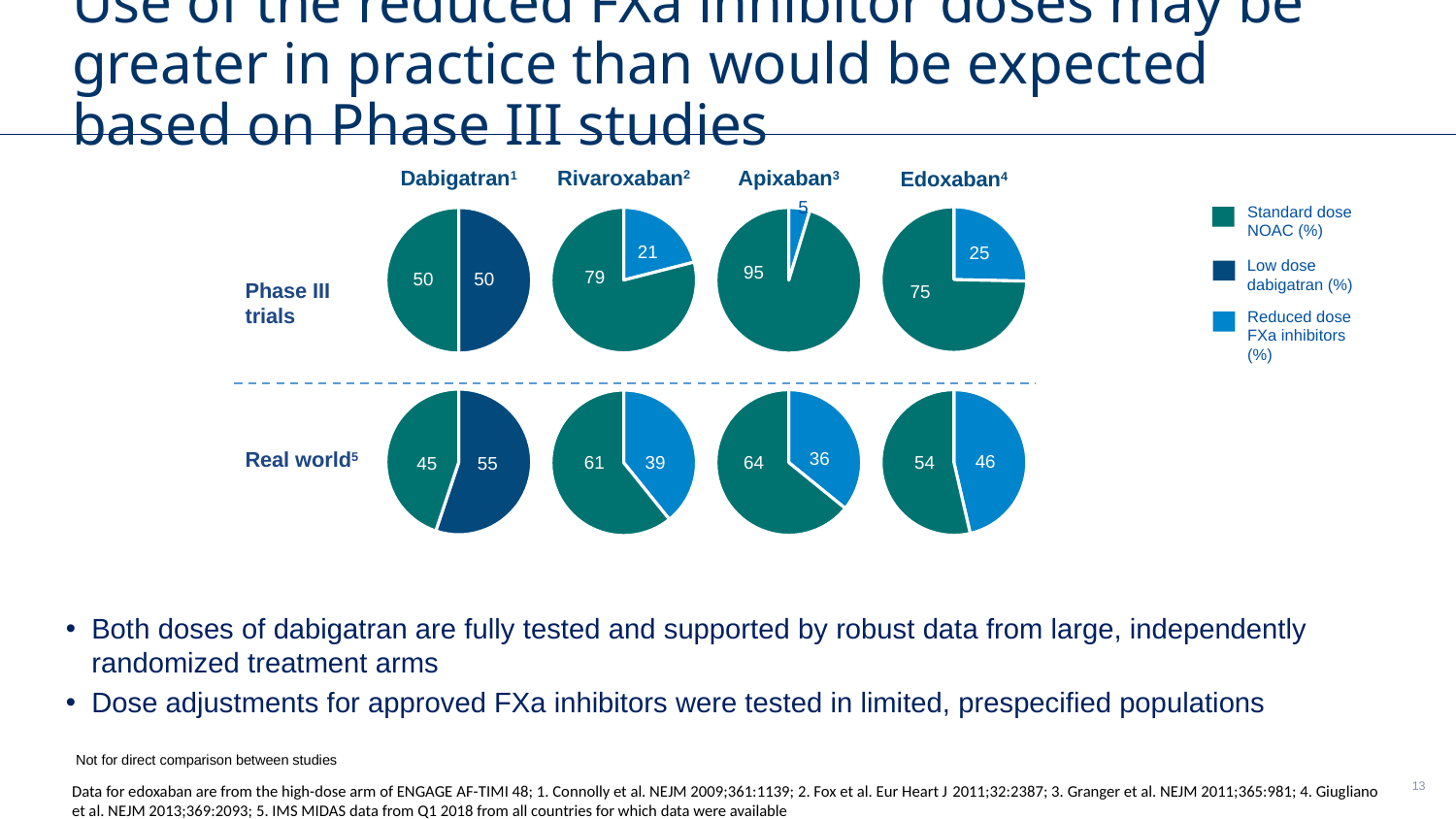
What kind of charts are used on this slide to show the dose distributions? Pie charts How many pie charts are shown on the slide? 8 What is the difference between the reduced dose FXa inhibitors share for Rivaroxaban in the Real world pie chart and in the Phase III trials pie chart? 18 In the Real world pie chart for Apixaban, what percentage is shown for the reduced dose FXa inhibitors slice? 36 In the Real world pie chart for Dabigatran, what percentage is shown for the low dose dabigatran slice? 55 In the Phase III trials pie chart for Rivaroxaban, what percentage is shown for the reduced dose FXa inhibitors slice? 21 In the Phase III trials pie chart for Edoxaban, what percentage is shown for the standard dose NOAC slice? 75 Is the reduced dose FXa inhibitors share for Edoxaban larger in the Real world pie chart or in the Phase III trials pie chart? Real world Across the Phase III trials pie charts, which drug has the largest standard dose NOAC share? Apixaban Across the Real world pie charts, which drug has the smallest reduced or low dose share? Apixaban In the Phase III trials pie chart for Dabigatran, what percentage is shown for the standard dose NOAC slice? 50 How many entries does the legend list? 3